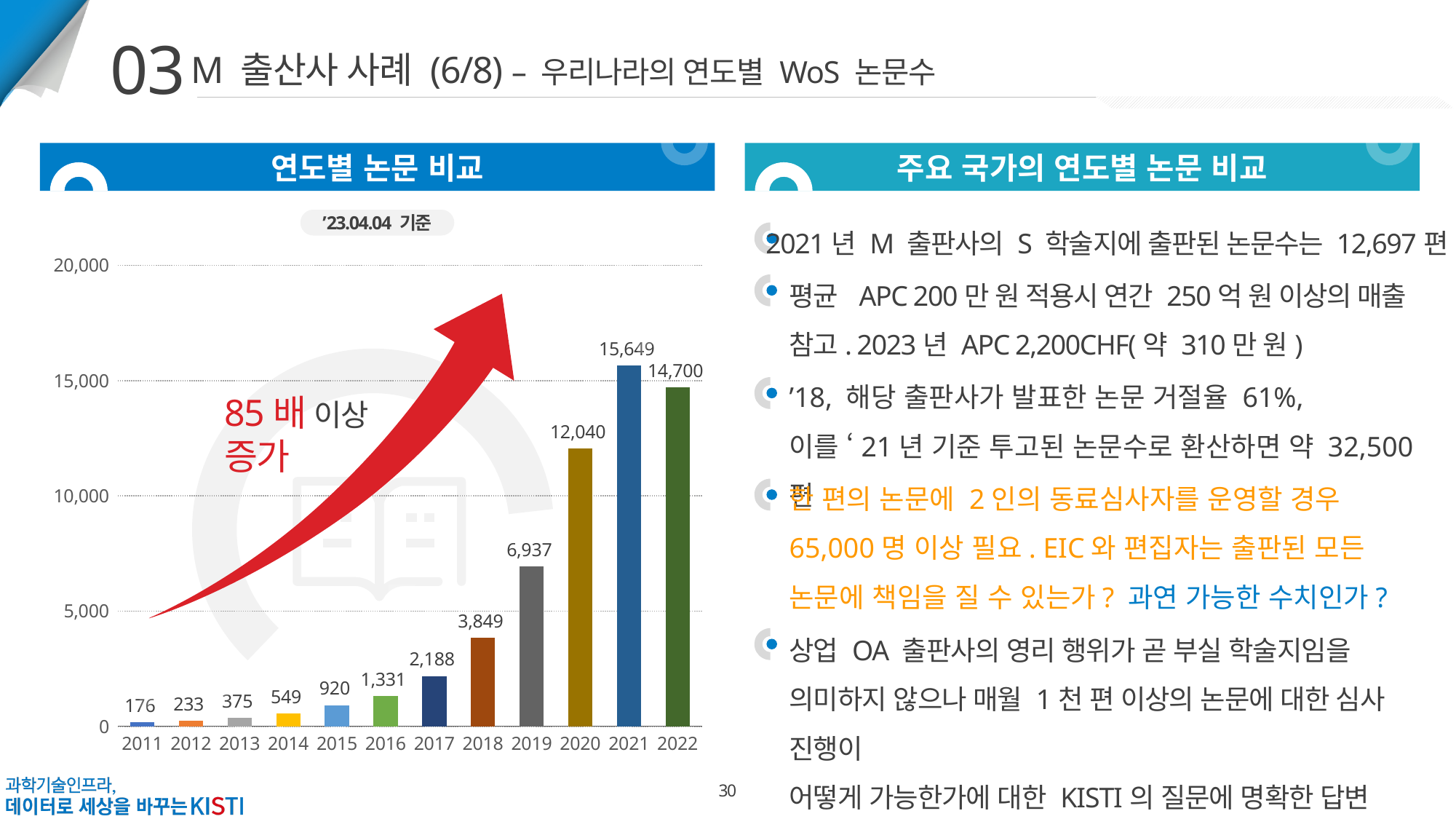
What kind of chart is shown on the slide? bar chart Is the value for 2020 greater or less than 10,000? greater What is the difference between the values for 2020 and 2019? 5,103 Which year has the highest value in the bar chart? 2021 What is the value for 2015 in the bar chart? 920 Which year has the lowest value in the bar chart? 2011 What is the difference between the values for 2021 and 2022? 949 What is the title of the chart on the left of the slide? 연도별 논문 비교 Which is larger, the value for 2018 or the value for 2017? 2018 What is the value for 2022 in the bar chart? 14,700 What is the value for 2019 in the bar chart? 6,937 How many years are shown on the x axis of the bar chart? 12